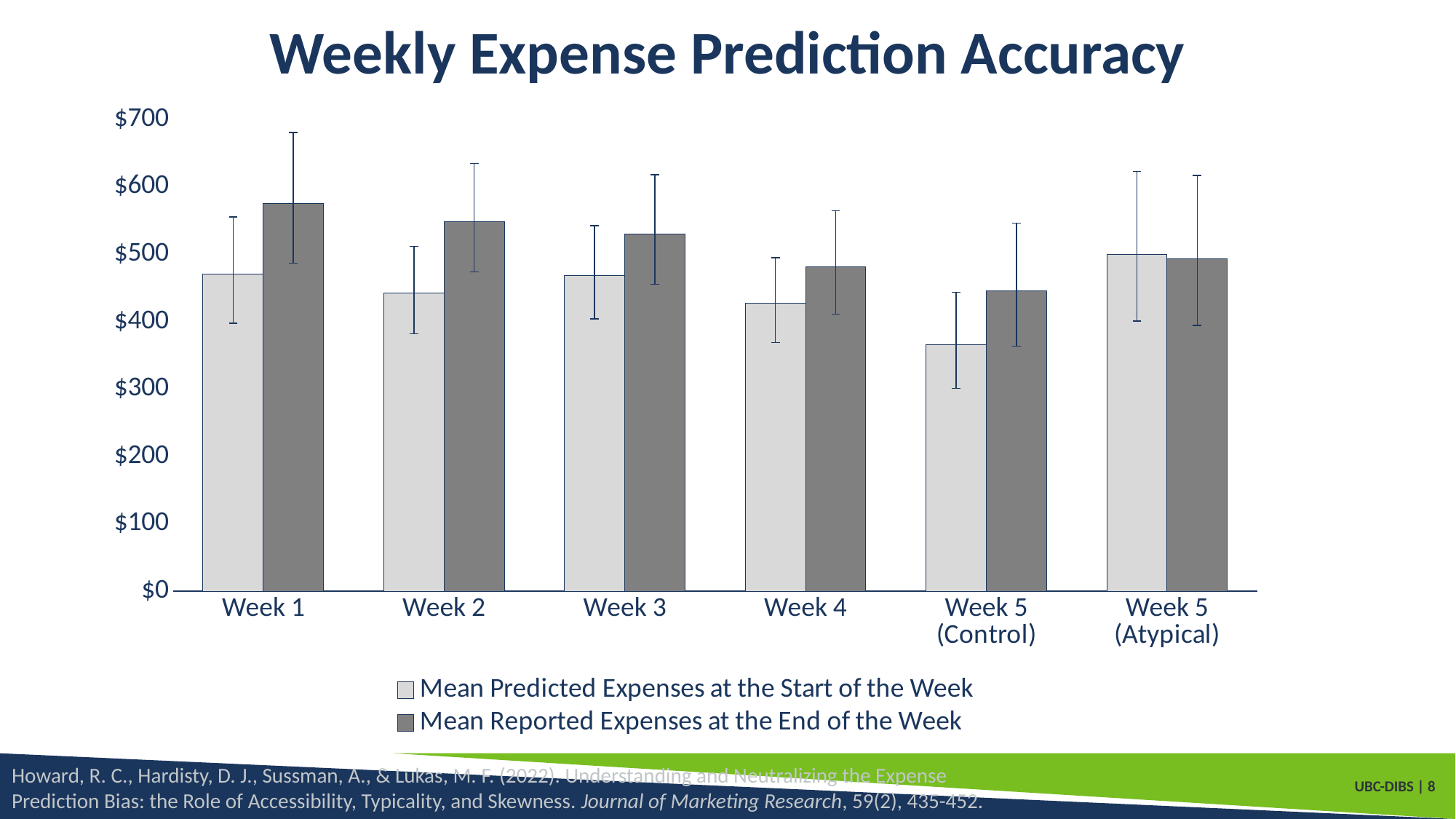
Is the Mean Predicted Expenses at the Start of the Week for Week 2 greater or less than $500? less Which category has the highest Mean Reported Expenses at the End of the Week? Week 1 How many series does the legend list? 2 Is the Mean Predicted Expenses at the Start of the Week for Week 5 (Control) greater or less than $400? less Is the Mean Reported Expenses at the End of the Week for Week 1 greater or less than $500? greater What kind of chart is shown on the slide? bar chart Which category has the lowest Mean Predicted Expenses at the Start of the Week? Week 5 (Control) Which category has the lowest Mean Reported Expenses at the End of the Week? Week 5 (Control) For Week 1, which is larger: Mean Predicted Expenses at the Start of the Week or Mean Reported Expenses at the End of the Week? Mean Reported Expenses at the End of the Week What is the title of the chart? Weekly Expense Prediction Accuracy How many week categories are shown on the x axis? 6 Do the Mean Reported Expenses at the End of the Week rise or fall from Week 1 to Week 5 (Control)? fall